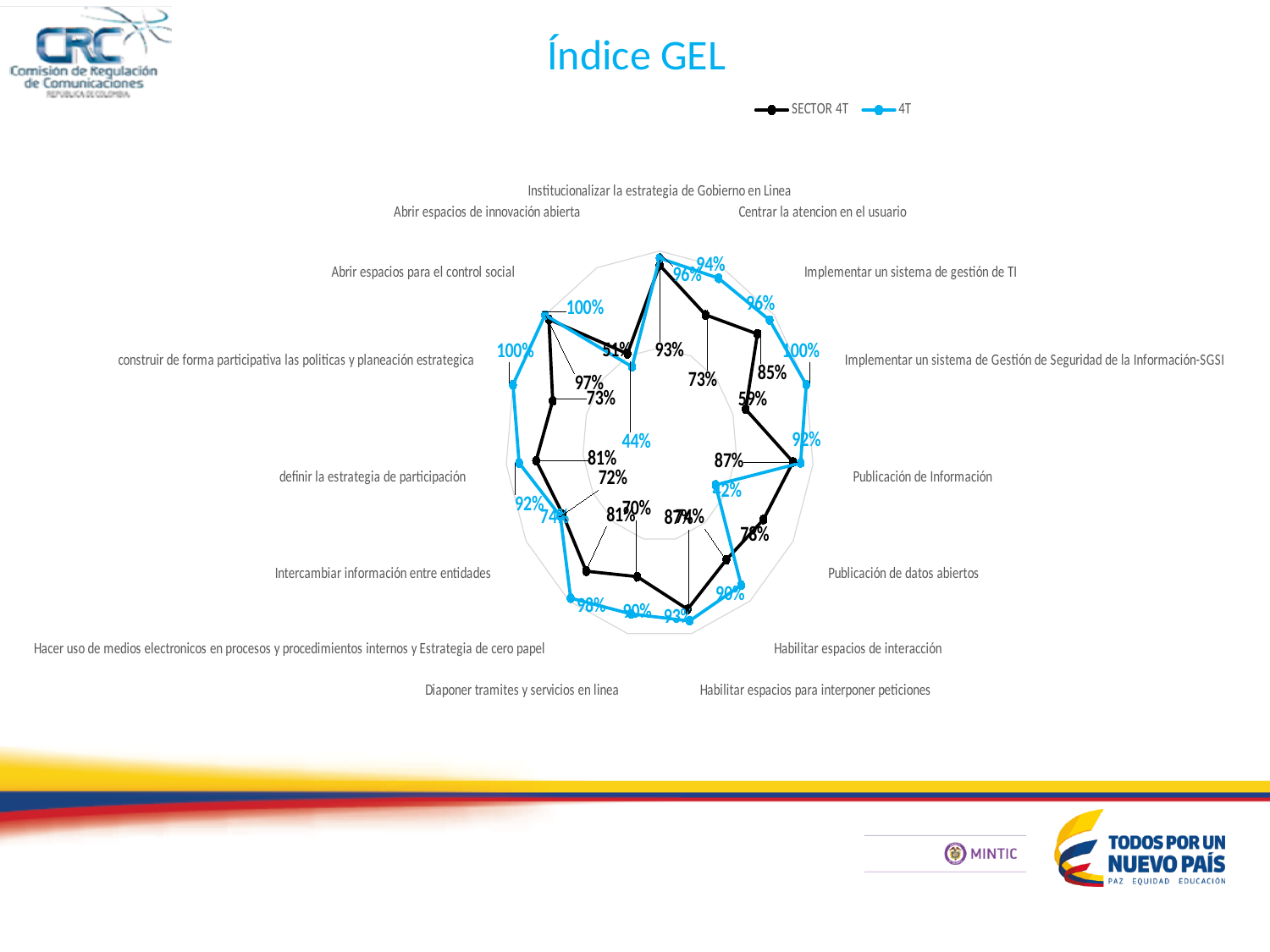
How many categories are plotted around the radar chart? 15 What are the two series named in the legend? SECTOR 4T and 4T What is the 4T value for 'Centrar la atencion en el usuario'? 94% For 'Implementar un sistema de Gestión de Seguridad de la Información-SGSI', which series has the larger value, SECTOR 4T or 4T? 4T What is the 4T value for 'Implementar un sistema de gestión de TI'? 96% What kind of chart is shown on the slide? Radar chart What is the 4T value for 'Abrir espacios de innovación abierta'? 44% What is the 4T value for 'Implementar un sistema de Gestión de Seguridad de la Información-SGSI'? 100% How many series does the legend list? 2 What is the title of the chart? Índice GEL Which category has the lowest 4T value? Publicación de datos abiertos What is the 4T value for 'Abrir espacios para el control social'? 100%